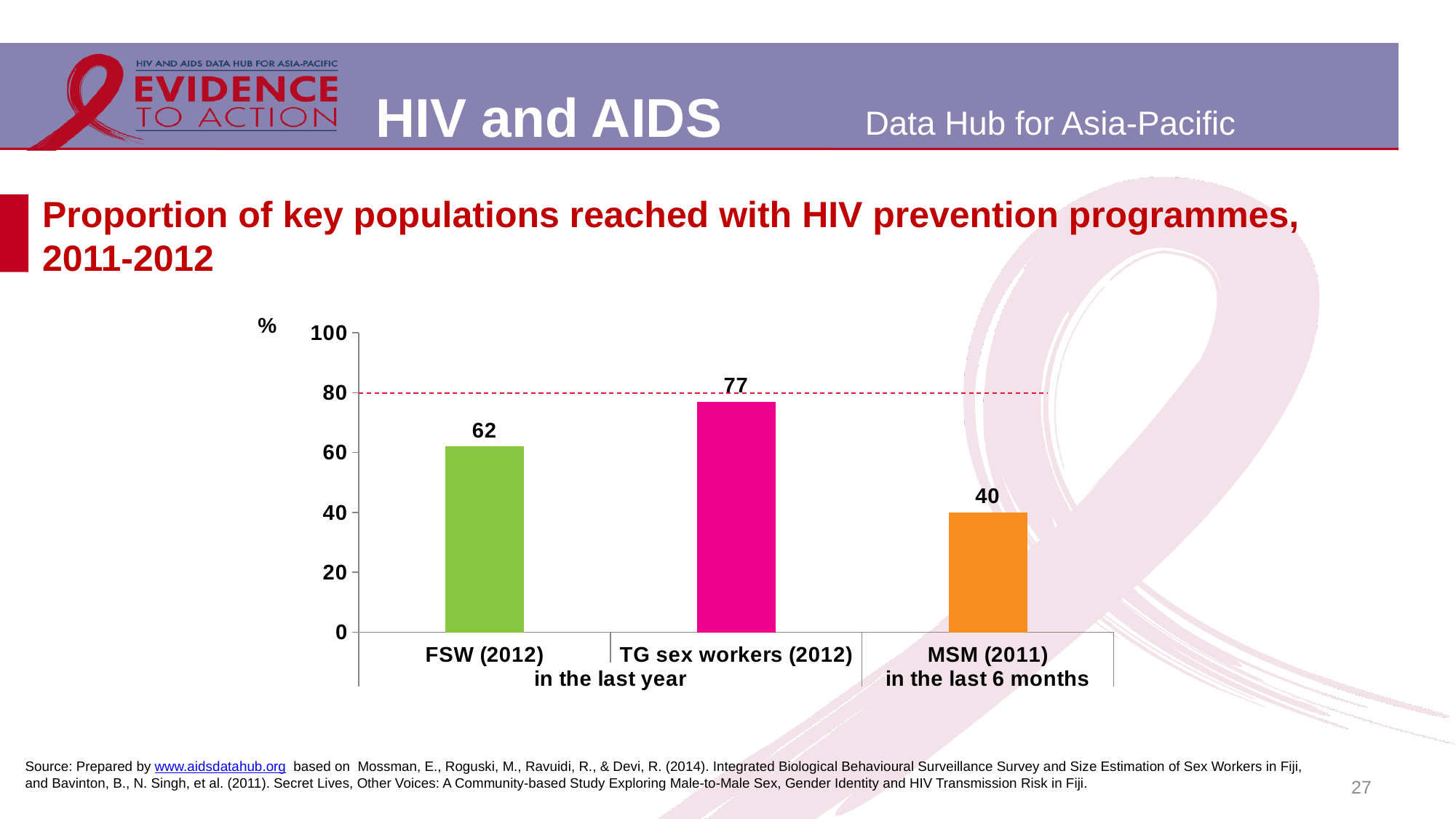
What is the difference between the values for FSW (2012) and MSM (2011)? 22 Which category has the lowest value? MSM (2011) Which category has the highest value? TG sex workers (2012) What is the value for FSW (2012)? 62 What kind of chart is shown on the slide? bar chart How many categories are shown in the chart? 3 What is the value for TG sex workers (2012)? 77 Is the value for TG sex workers (2012) greater or less than 80? less What is the value for MSM (2011)? 40 What is the title of the chart on the slide? Proportion of key populations reached with HIV prevention programmes, 2011-2012 Which is larger, the value for FSW (2012) or the value for MSM (2011)? FSW (2012) What is the difference between the values for TG sex workers (2012) and FSW (2012)? 15